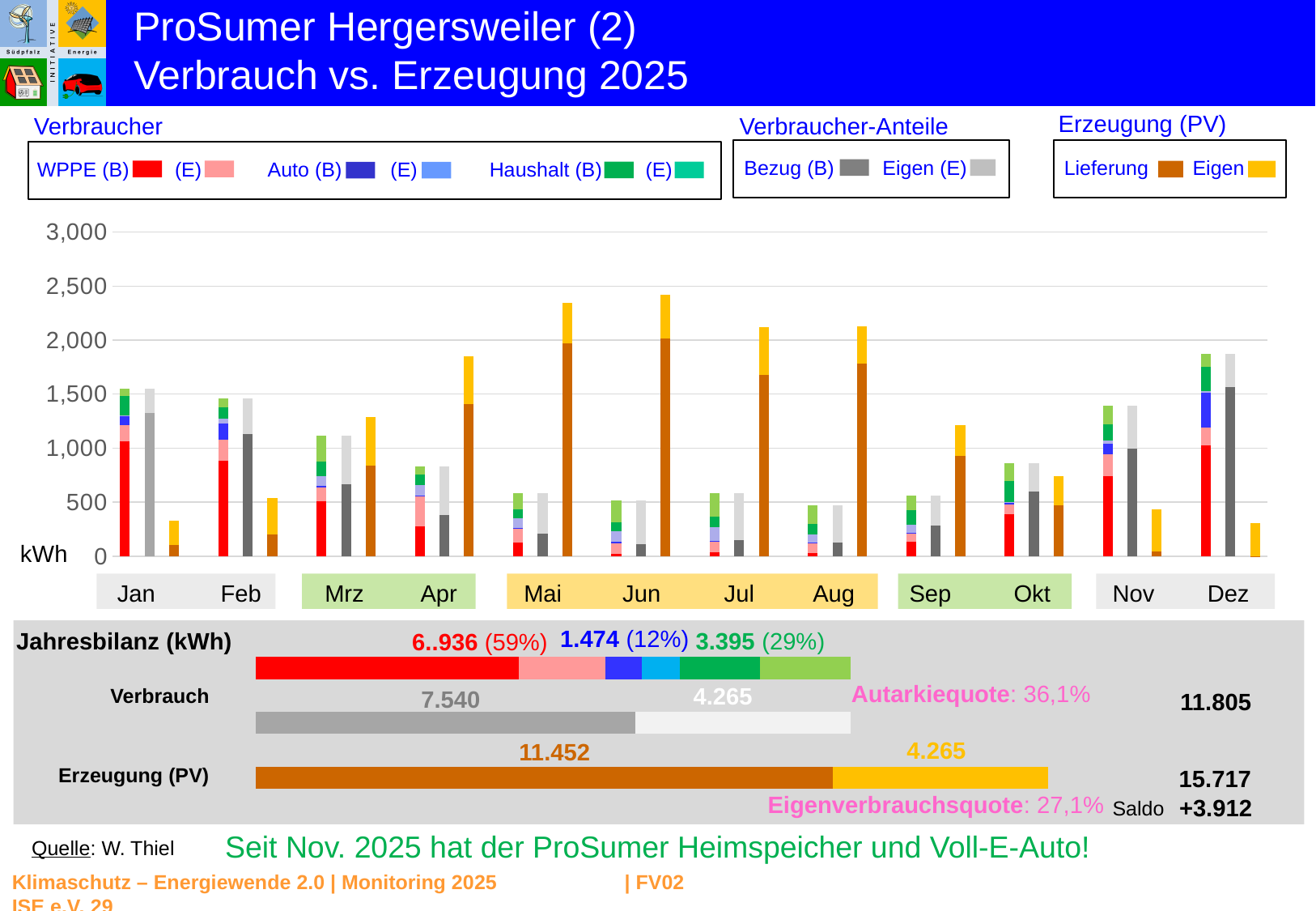
Is the total Verbraucher bar for Aug greater or less than 1,000 kWh? less Is the total PV Erzeugung bar for Jan greater or less than 500 kWh? less Which month has the highest total Verbraucher (consumption) bar? Dez How many entries does the Verbraucher legend list? 6 In the Jahresbilanz, what is the total Verbrauch in kWh? 11.805 Does the PV Erzeugung bar rise or fall from Jan to Jun? rise Is the total PV Erzeugung bar for Jun greater or less than 2,000 kWh? greater How many months are shown on the x axis of the monthly chart? 12 In Jan, which is larger: the total Verbraucher bar or the PV Erzeugung bar? Verbraucher bar What kind of chart is used to show the monthly Verbrauch and Erzeugung values? bar chart How many entries does the Erzeugung (PV) legend list? 2 In the Jahresbilanz, what is the Autarkiequote? 36,1%